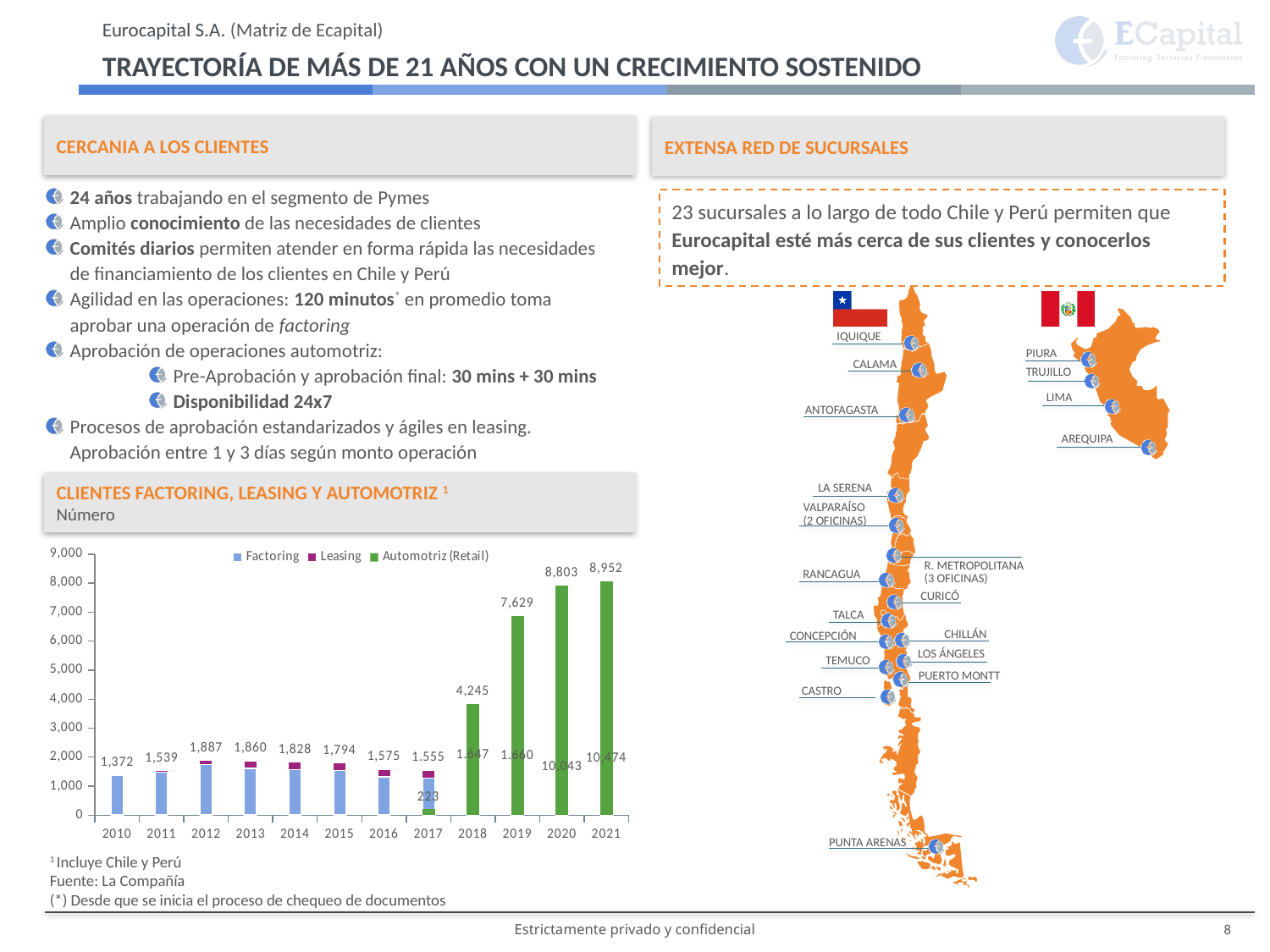
Which year has the larger Automotriz (Retail) value, 2018 or 2019? 2019 What value is labelled above the 2010 bar? 1,372 Do the Automotriz (Retail) values rise or fall from 2017 to 2021? rise How many years are shown on the x axis of the chart? 12 What value is labelled for Automotriz (Retail) in 2019? 7,629 How many series does the legend of the chart list? 3 What is the difference between the Automotriz (Retail) values for 2021 and 2020? 149 What kind of chart is shown on the slide? bar chart Is the Automotriz (Retail) value for 2018 greater or less than 5,000? less What value is labelled for Automotriz (Retail) in 2018? 4,245 In which year is the Automotriz (Retail) bar the highest? 2021 What value is labelled for Automotriz (Retail) in 2017? 223